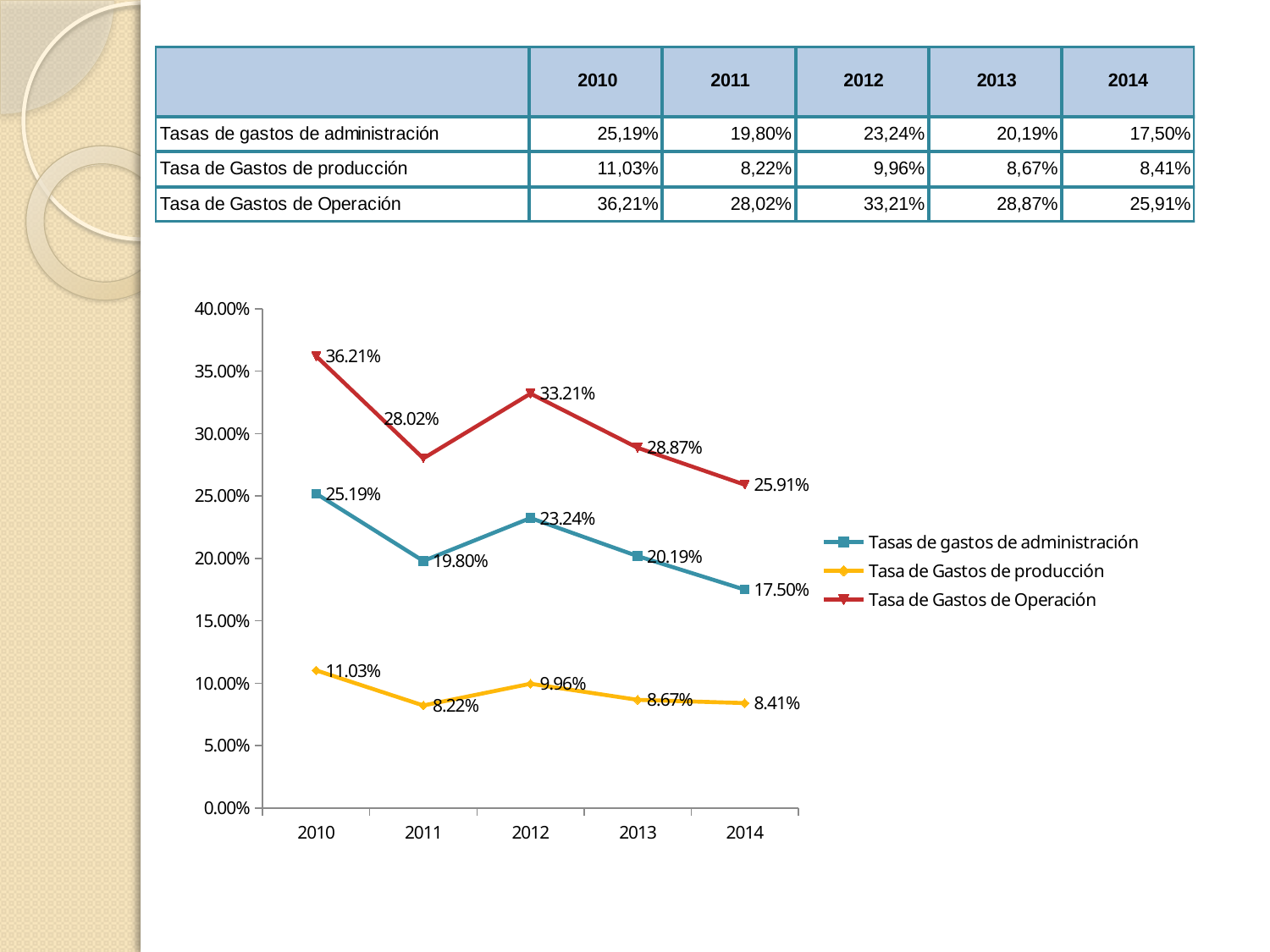
In which year is Tasa de Gastos de Operación highest on the chart? 2010 Which colour is used for the Tasa de Gastos de Operación line on the chart? Red What is the difference between Tasa de Gastos de Operación in 2010 and in 2014 on the chart? 10.30 percentage points What type of chart is shown on the slide? Line chart Does Tasas de gastos de administración rise or fall overall from 2010 to 2014 on the chart? Fall How many years are plotted along the x axis of the chart? 5 In which year is Tasa de Gastos de producción lowest on the chart? 2011 How many series does the chart legend list? 3 What is the value of Tasa de Gastos de Operación in 2010 on the chart? 36.21% What is the value of Tasa de Gastos de producción in 2012 on the chart? 9.96% What is the value of Tasas de gastos de administración in 2014 on the chart? 17.50% Which is larger on the chart: Tasas de gastos de administración in 2012 or in 2013? 2012